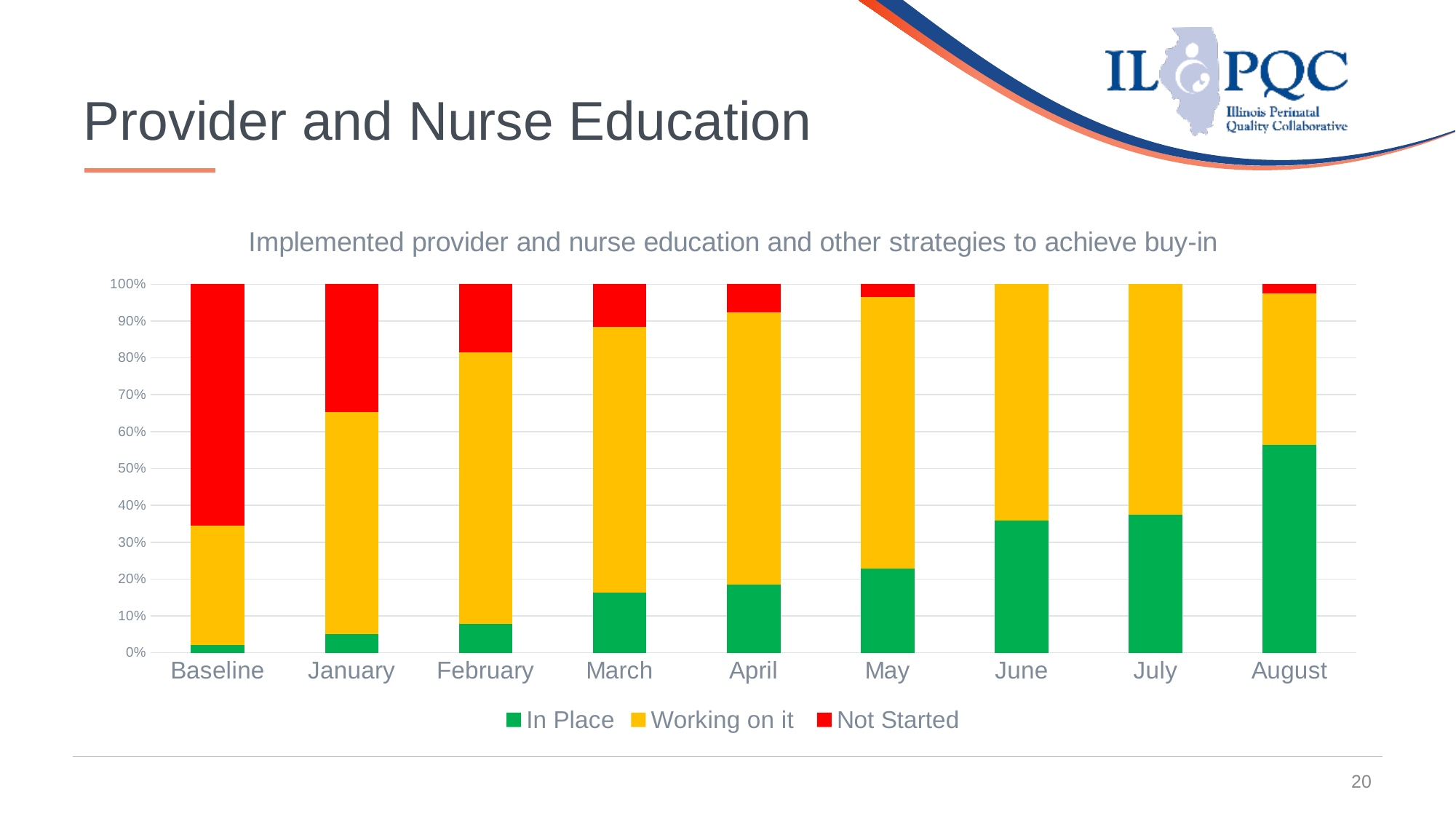
Is the 'In Place' share for June greater or less than 30%? greater Does the 'In Place' share rise or fall from Baseline to August? rise How many categories are shown along the x axis? 9 Which month has the largest 'In Place' share? August Is the 'In Place' share for August greater or less than 50%? greater What are the three legend entries of the chart? In Place, Working on it, Not Started What kind of chart is shown on the slide? Stacked bar chart How many series does the legend list? 3 Which category has the largest 'Not Started' share? Baseline Which category has the smallest 'In Place' share? Baseline Which has a larger 'Not Started' share, January or February? January Is the 'Not Started' share for Baseline greater or less than 60%? greater